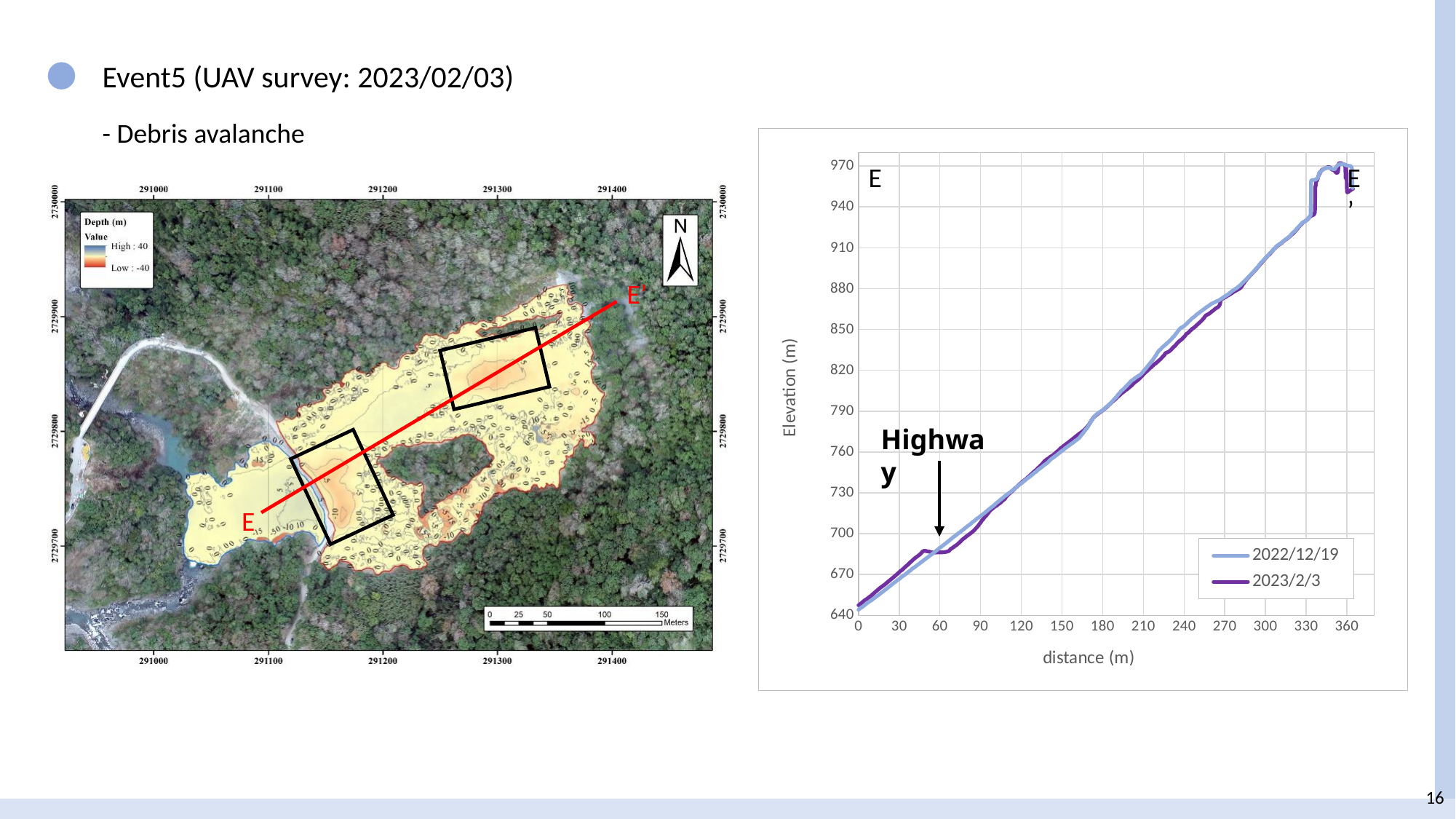
In the elevation chart, is the elevation at distance 210 m greater or less than 790? greater In the elevation chart, is the elevation at distance 150 m greater or less than 730? greater In the elevation chart, is the elevation at distance 150 m greater or less than 790? less In the elevation chart, do the elevation values rise or fall as distance increases from 0 to 330 m? rise What is the label of the x axis of the elevation chart? distance (m) In the elevation chart, which distance has the higher elevation: 60 m or 300 m? 300 m How many series does the legend of the elevation chart list? 2 What are the two series named in the legend of the elevation chart? 2022/12/19 and 2023/2/3 What kind of chart is shown on the right side of the slide? line chart